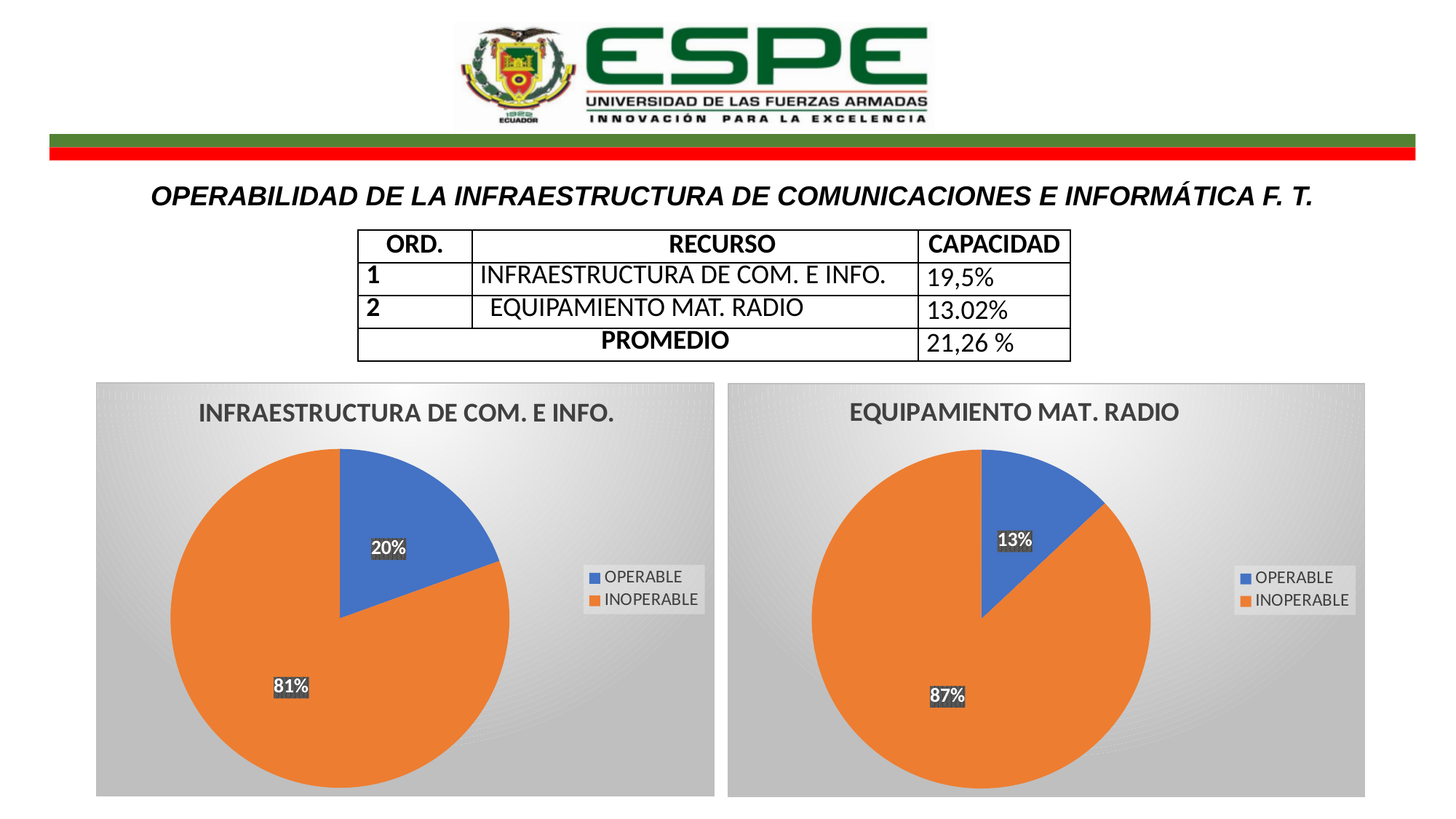
What kind of chart is the 'EQUIPAMIENTO MAT. RADIO' chart? Pie chart In the 'EQUIPAMIENTO MAT. RADIO' chart, what share of the pie is INOPERABLE? 87% In the 'INFRAESTRUCTURA DE COM. E INFO.' chart, what is the difference between the INOPERABLE and OPERABLE shares? 61% In the 'EQUIPAMIENTO MAT. RADIO' chart, which slice is the smallest? OPERABLE In the 'EQUIPAMIENTO MAT. RADIO' chart, what share of the pie is OPERABLE? 13% In the 'INFRAESTRUCTURA DE COM. E INFO.' chart, what share of the pie is OPERABLE? 20% Which chart has the larger OPERABLE share, 'INFRAESTRUCTURA DE COM. E INFO.' or 'EQUIPAMIENTO MAT. RADIO'? INFRAESTRUCTURA DE COM. E INFO. In the 'EQUIPAMIENTO MAT. RADIO' chart, what is the difference between the INOPERABLE and OPERABLE shares? 74% In the 'EQUIPAMIENTO MAT. RADIO' chart, what colour is the INOPERABLE slice? Orange How many slices does the 'INFRAESTRUCTURA DE COM. E INFO.' pie chart have? 2 In the 'INFRAESTRUCTURA DE COM. E INFO.' chart, which slice is the largest? INOPERABLE